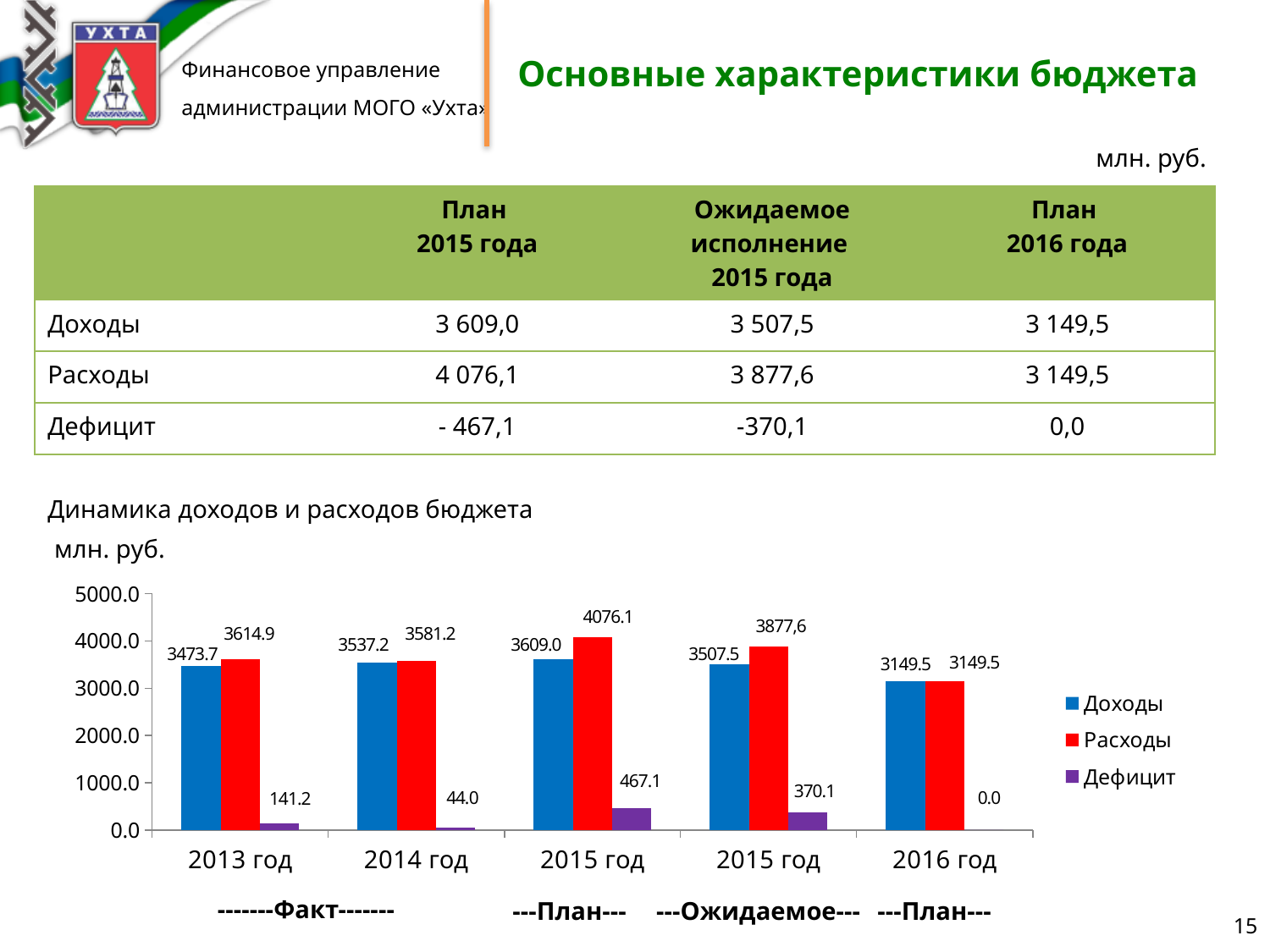
What is the value of Дефицит for 2014 год in the chart? 44.0 Which is larger in the chart for 2014 год: Доходы or Расходы? Расходы In which year category is Расходы highest in the chart? 2015 год (План) Which series in the chart legend is shown in red? Расходы What type of chart is shown on the slide? bar chart What is the value of Расходы for 2015 год (План) in the chart? 4076.1 How many year categories are shown on the x axis of the chart? 5 In which year category is Дефицит lowest in the chart? 2016 год How many series does the chart legend list? 3 What is the value of Доходы for 2015 год (Ожидаемое) in the chart? 3507.5 What is the value of Доходы for 2013 год in the chart? 3473.7 What is the difference between Расходы and Доходы for 2013 год in the chart? 141.2